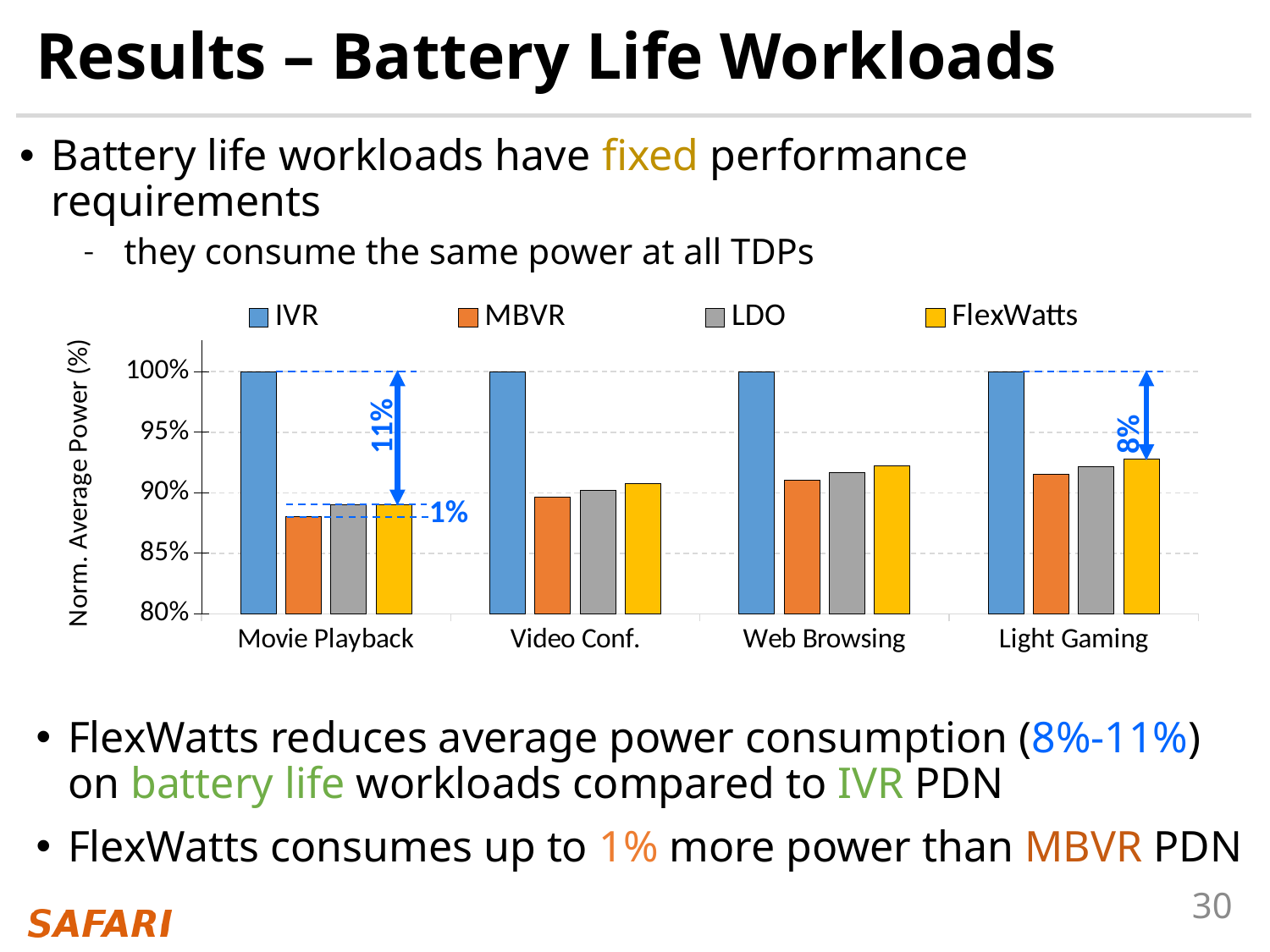
In the Light Gaming category, which is larger: the MBVR bar or the FlexWatts bar? FlexWatts Is the value for MBVR in the Video Conf. category greater or less than 90%? less Which series has the lowest value in the Web Browsing category? MBVR What is the label of the chart's y axis? Norm. Average Power (%) Is the value for FlexWatts in the Web Browsing category greater or less than 90%? greater What is the normalized average power for IVR in the Light Gaming category? 100% What is the normalized average power for IVR in the Movie Playback category? 100% How many series does the chart's legend list? 4 How many workload categories are shown on the x axis of the chart? 4 What kind of chart is shown on the slide? bar chart Is the value for MBVR in the Movie Playback category greater or less than 90%? less Which series has the highest value in the Video Conf. category? IVR